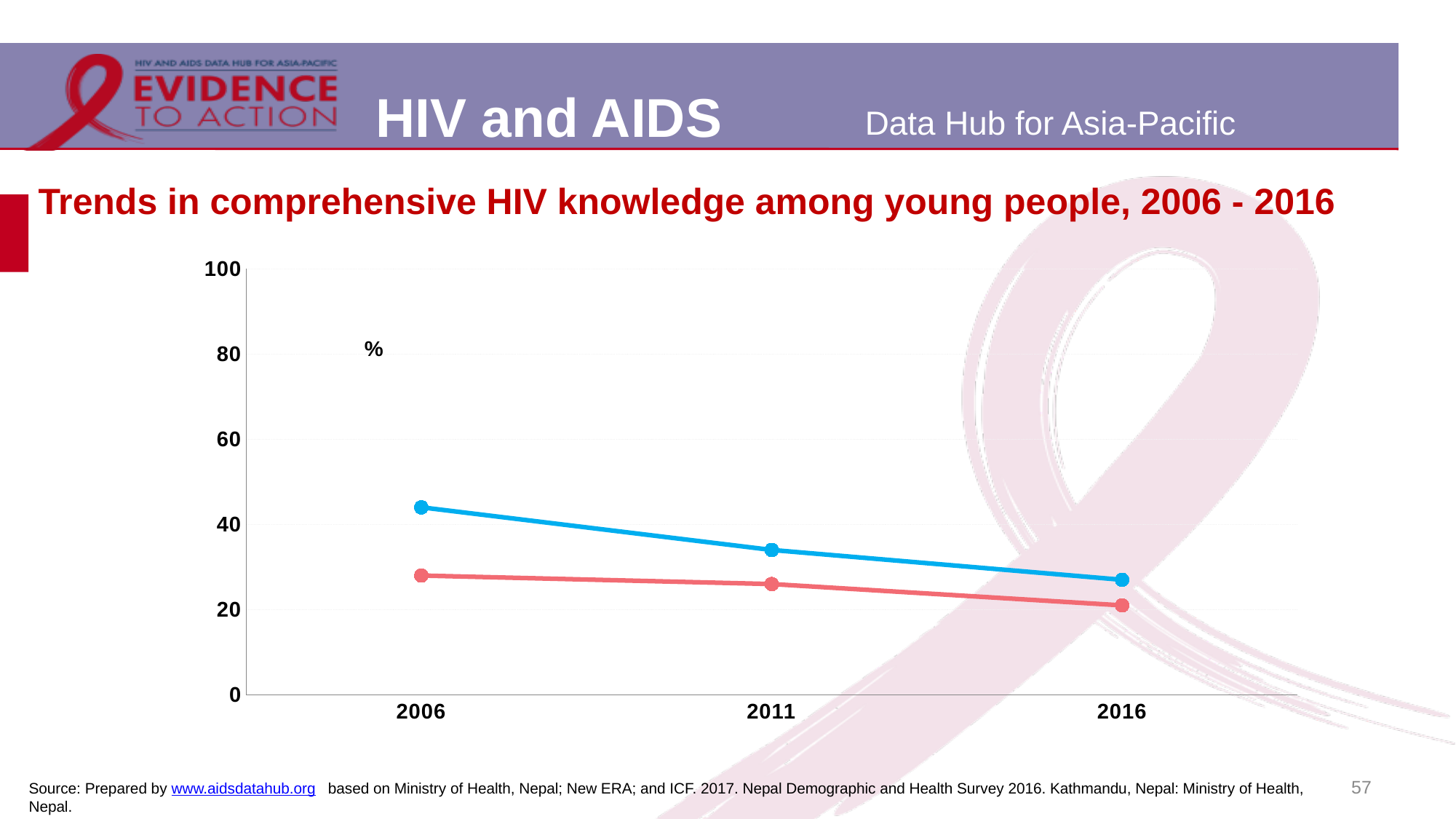
Does the blue line rise or fall from 2006 to 2016? fall Which years are shown on the x axis of the chart? 2006, 2011, 2016 Is the value of the red line in 2006 greater or less than 40? less In 2006, which line has the higher value, the blue line or the red line? blue line In which year does the blue line reach its highest value? 2006 Is the value of the blue line in 2016 greater or less than 40? less In which year does the red line reach its lowest value? 2016 What kind of chart is shown on the slide? line chart Does the red line rise or fall from 2006 to 2016? fall How many years are plotted along the x axis of the chart? 3 Is the value of the blue line in 2006 greater or less than 40? greater